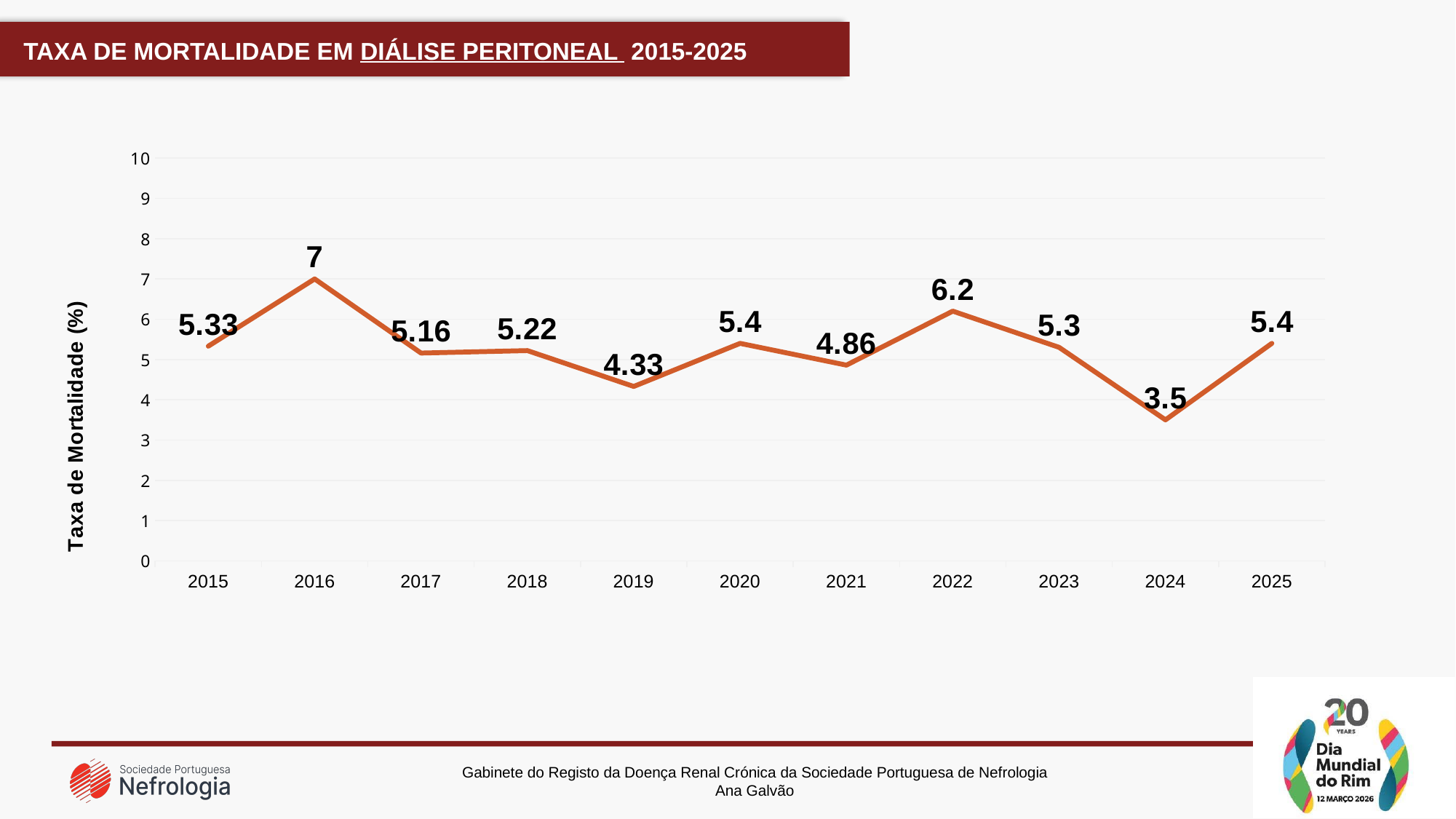
What is the difference between the mortality rate in 2022 and in 2024? 2.7 What kind of chart is shown on the slide? line chart Is the mortality rate for 2016 greater or less than 6? greater What is the mortality rate in peritoneal dialysis for 2019? 4.33 Which year has the highest mortality rate in peritoneal dialysis? 2016 What is the mortality rate in peritoneal dialysis for 2024? 3.5 What is the label of the vertical axis? Taxa de Mortalidade (%) How many years are plotted on the chart? 11 What is the mortality rate in peritoneal dialysis for 2016? 7 Does the mortality rate rise or fall from 2022 to 2024? fall Which year has a higher mortality rate, 2021 or 2023? 2023 Which year has the lowest mortality rate in peritoneal dialysis? 2024